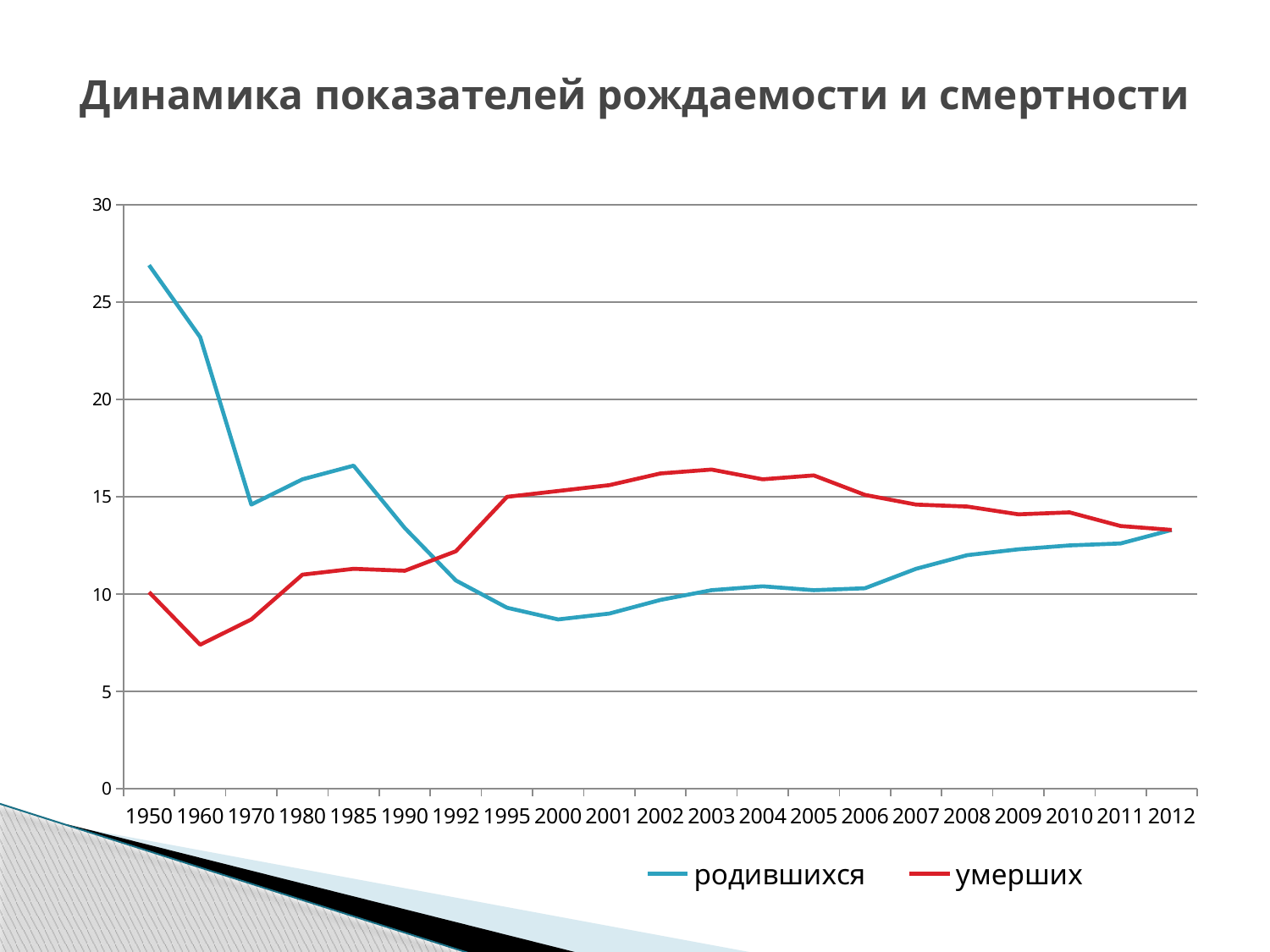
Is the value for умерших in 1960 greater or less than 10? less Does the value for родившихся rise or fall from 1950 to 2000? fall Which series has the larger value in 2005, родившихся or умерших? умерших In which year is the value for умерших lowest? 1960 How many series does the legend list? 2 In which year is the value for родившихся lowest? 2000 Which series is drawn in red? умерших What kind of chart is shown on the slide? line chart What is the title of the chart? Динамика показателей рождаемости и смертности In which year is the value for родившихся highest? 1950 Is the value for родившихся in 1950 greater or less than 25? greater How many years are shown on the x axis? 21